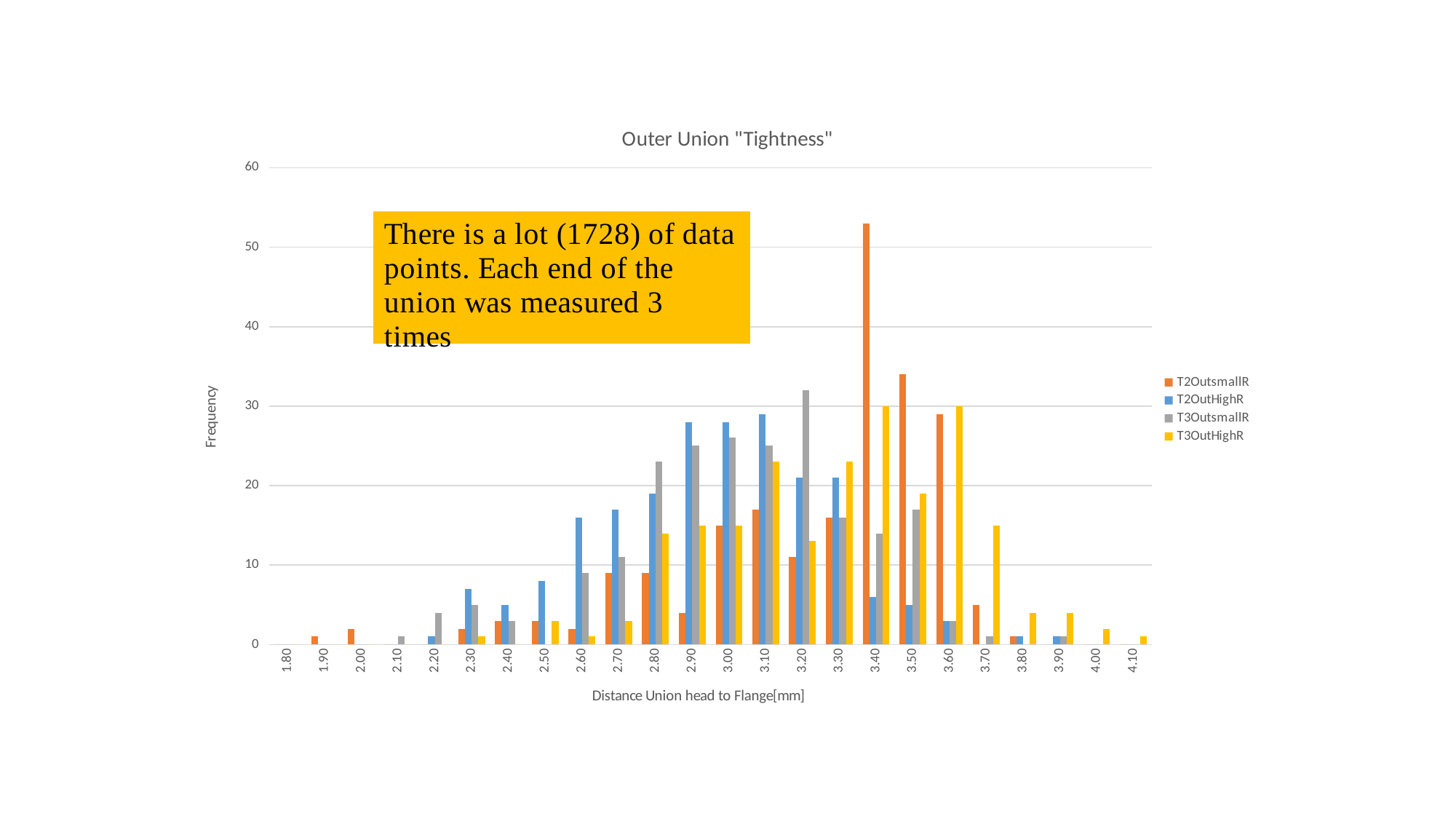
Is the value for T2OutHighR at 2.90 greater or less than 30? less At 2.60, which is larger: T2OutHighR or T3OutsmallR? T2OutHighR At which x-axis category does the T2OutsmallR series reach its highest value? 3.40 Which series has the tallest bar in the chart? T2OutsmallR How many series does the legend list? 4 Is the value for T2OutsmallR at 3.40 greater or less than 50? greater What kind of chart is shown on the slide? bar chart How many categories are shown along the x axis? 24 What is the title of the chart? Outer Union "Tightness" Is the value for T3OutsmallR at 3.20 greater or less than 30? greater At 3.40, which is larger: T2OutsmallR or T2OutHighR? T2OutsmallR What is the label of the x axis? Distance Union head to Flange[mm]